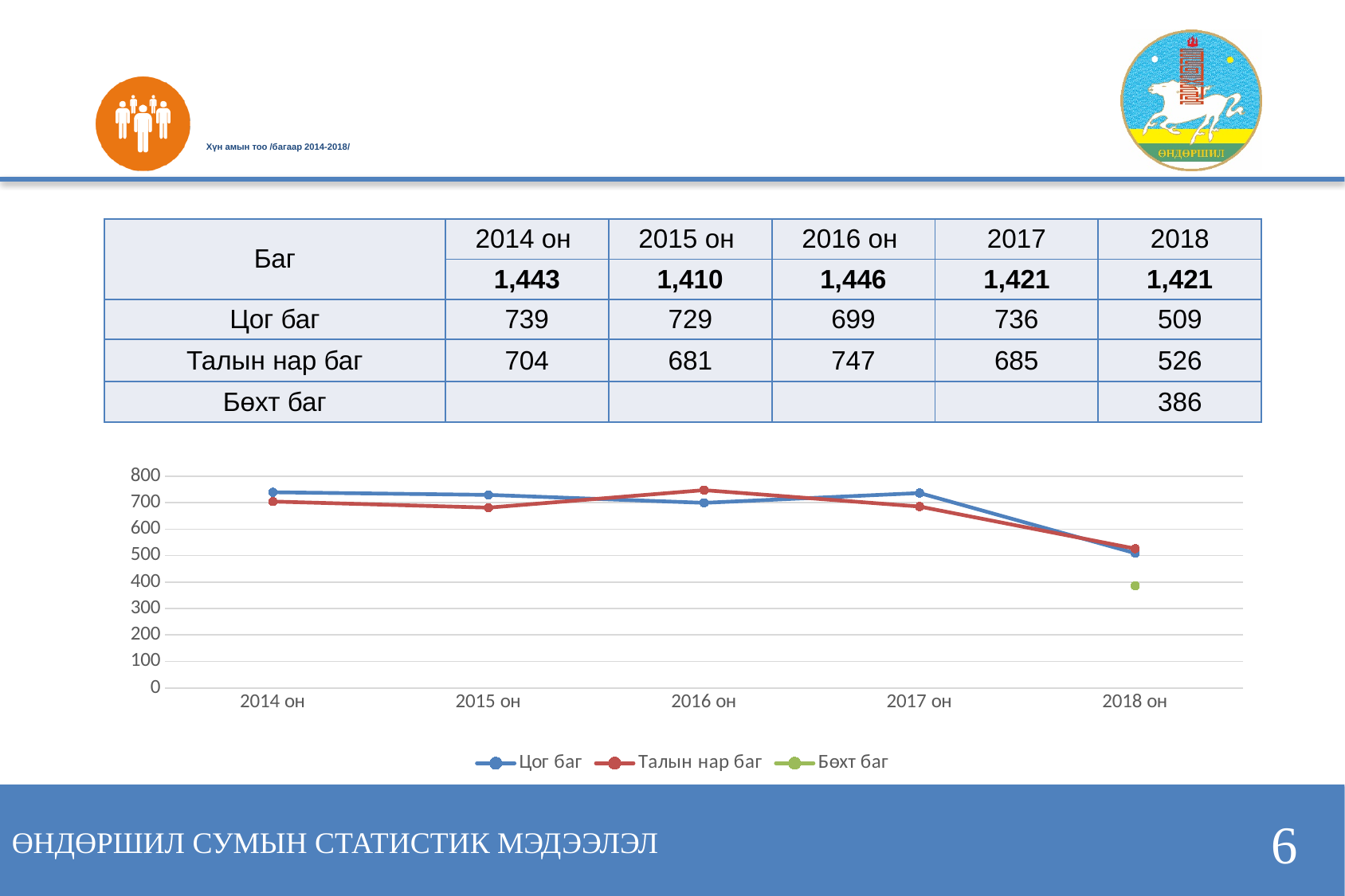
In which year is the value for Талын нар баг highest? 2016 он How many years are shown along the x axis of the chart? 5 What is the difference between the Цог баг values for 2014 он and 2018 он? 230 In which year is the value for Цог баг lowest? 2018 он In 2016 он, which series has the larger value, Цог баг or Талын нар баг? Талын нар баг What kind of chart is shown on the slide? line chart What is the value for Бөхт баг in 2018 он? 386 Does the Цог баг line rise or fall from 2017 он to 2018 он? fall Is the value for Бөхт баг in 2018 он greater or less than 400? less How many series does the chart legend list? 3 What is the value for Цог баг in 2014 он? 739 What is the value for Талын нар баг in 2016 он? 747